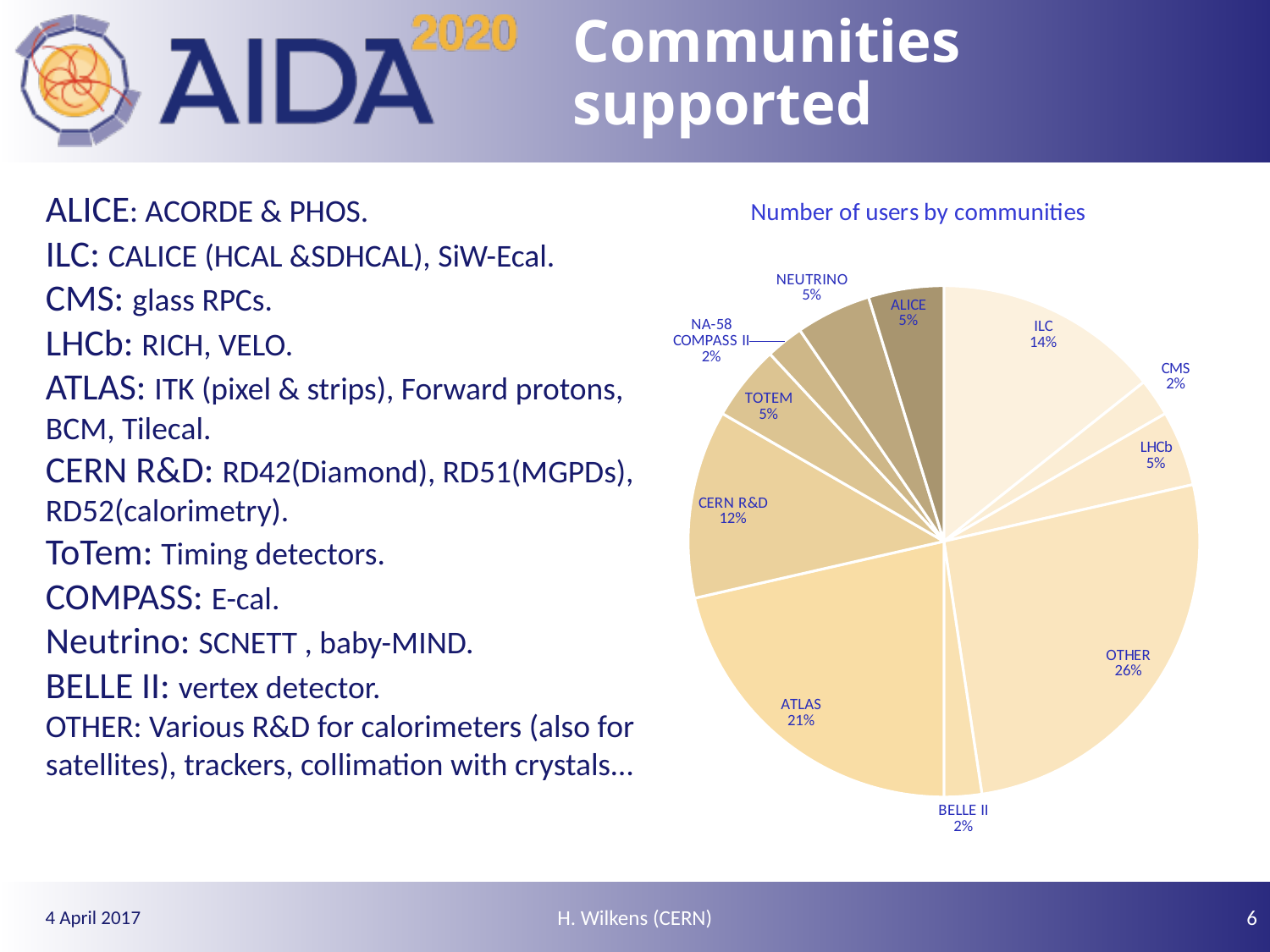
What percentage of users is attributed to CERN R&D? 12% How many communities (slices) are shown in the pie chart? 11 Which community has the largest share of users? OTHER What percentage of users is attributed to ILC? 14% Which has a larger share of users, ILC or LHCb? ILC What percentage of users is attributed to BELLE II? 2% What share of users does the OTHER community account for? 26% What is the title of the chart? Number of users by communities What is the difference in percentage points between the OTHER and ILC shares? 12 What is the difference in percentage points between the ATLAS and CERN R&D shares? 9 What percentage of users is attributed to ATLAS? 21% What type of chart is shown on the slide? pie chart